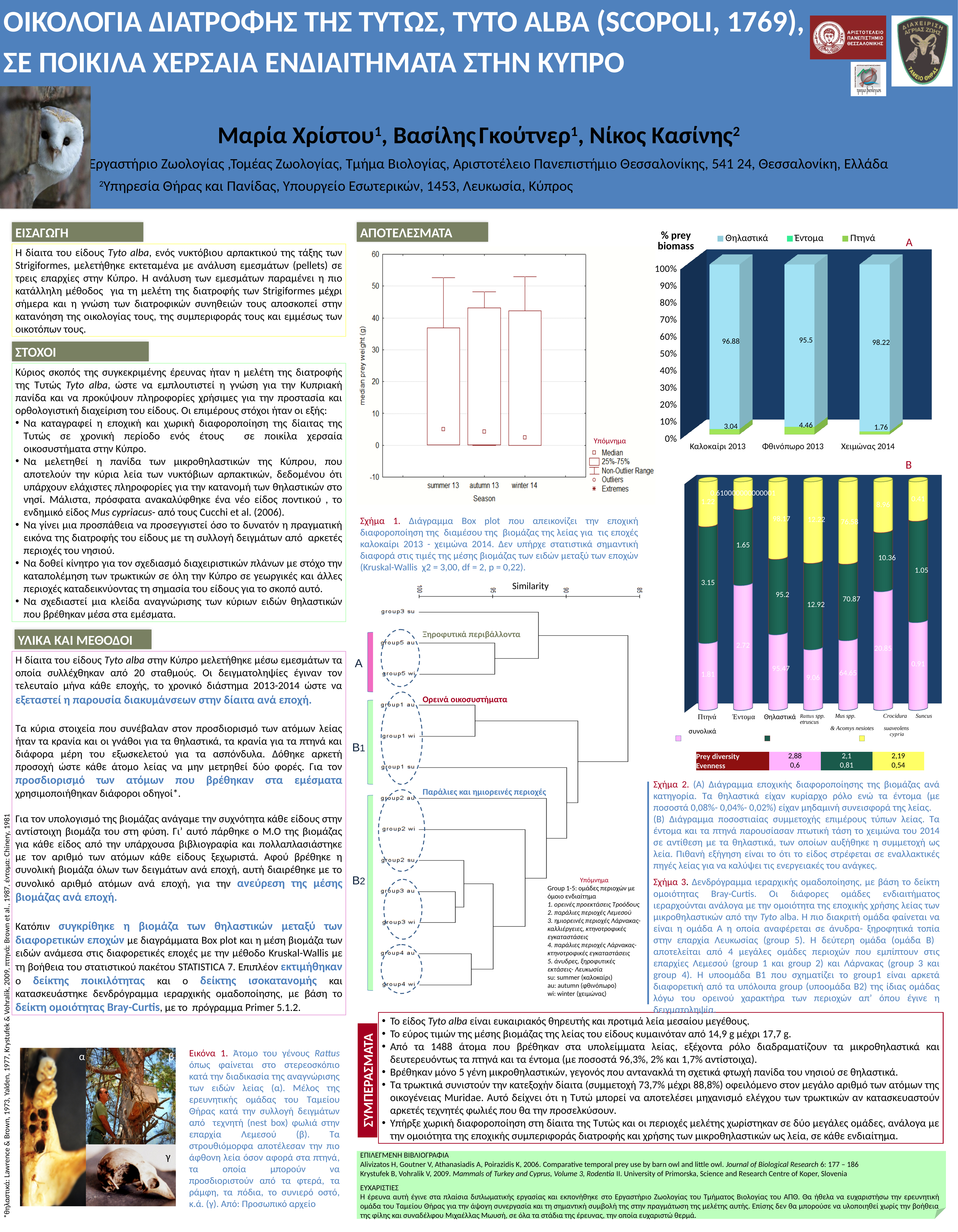
In the '% prey biomass' bar chart (top right), which season has the highest value for Θηλαστικά? Χειμώνας 2014 What kind of chart is Σχήμα 1 (median prey weight by season)? box plot In the '% prey biomass' bar chart (top right), what is the value for Θηλαστικά in Καλοκαίρι 2013? 96.88 In the '% prey biomass' bar chart (top right), what is the difference between the Θηλαστικά values for Χειμώνας 2014 and Φθινόπωρο 2013? 2.72 In the '% prey biomass' bar chart (top right), which season has the lowest value for Πτηνά? Χειμώνας 2014 How many seasons are shown on the x axis of the '% prey biomass' bar chart (top right)? 3 In the '% prey biomass' bar chart (top right), what is the value for Πτηνά in Φθινόπωρο 2013? 4.46 In the box plot of median prey weight (Σχήμα 1), is the median for summer 13 greater or less than 10? less In the '% prey biomass' bar chart (top right), is the Πτηνά value for Καλοκαίρι 2013 larger or smaller than that for Φθινόπωρο 2013? smaller How many series does the legend of the '% prey biomass' bar chart (top right) list? 3 In the stacked bar chart labelled B (right side), what is the value of the dark green middle segment for Θηλαστικά? 95.2 In the stacked bar chart labelled B (right side), what is the value of the pink bottom segment for Crocidura suaveolens? 20.85